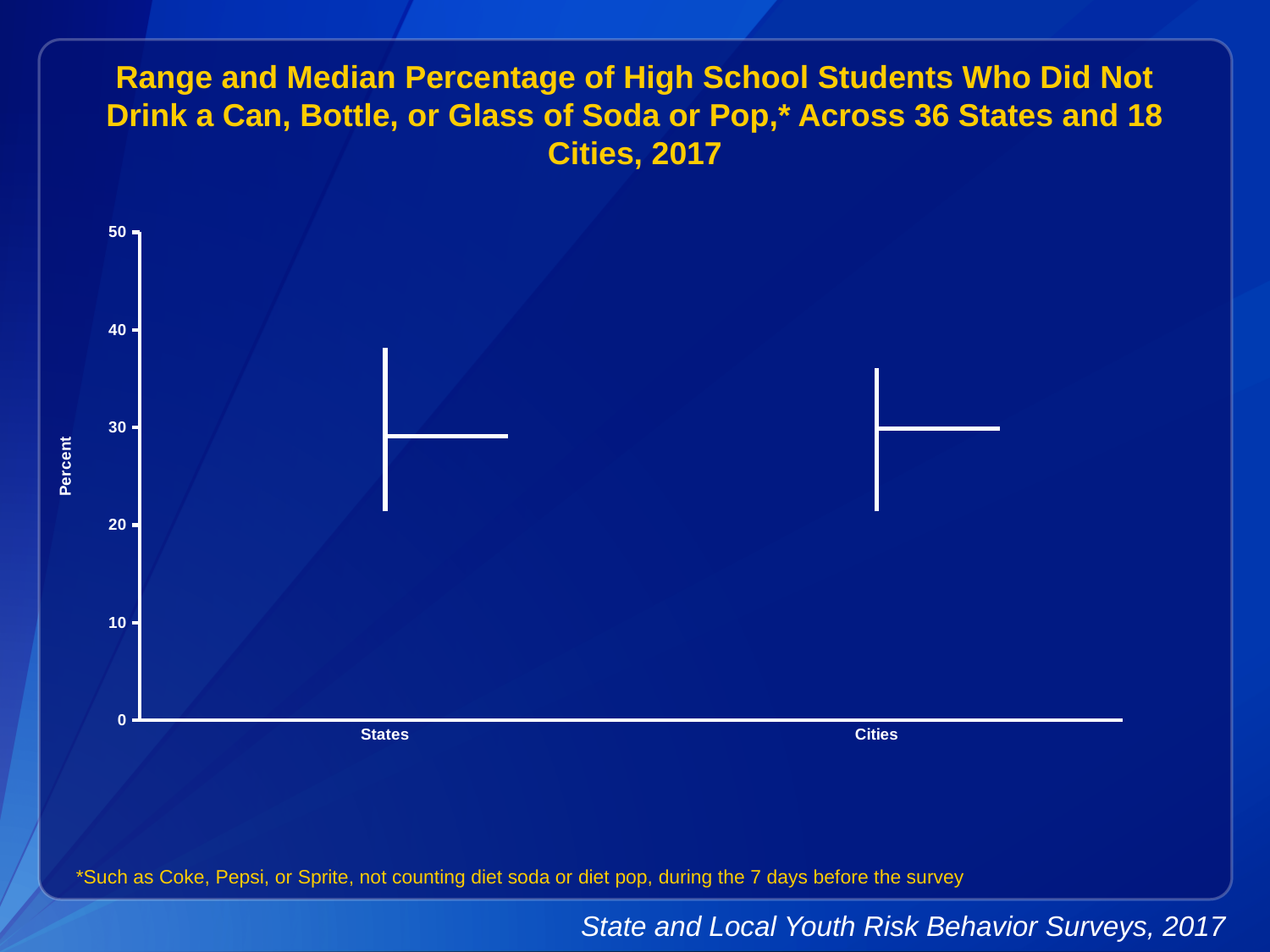
Is the median value for Cities greater or less than 40? less Is the top of the range for Cities greater or less than 30? greater How many categories are shown on the x axis of the chart? 2 Is the bottom of the range for Cities greater or less than 20? greater According to the title, how many cities are included in the chart? 18 Which category has the higher top of its range, States or Cities? States What are the two categories shown on the x axis? States and Cities What is the highest value shown on the y axis? 50 What is the label of the y axis? Percent According to the title, how many states are included in the chart? 36